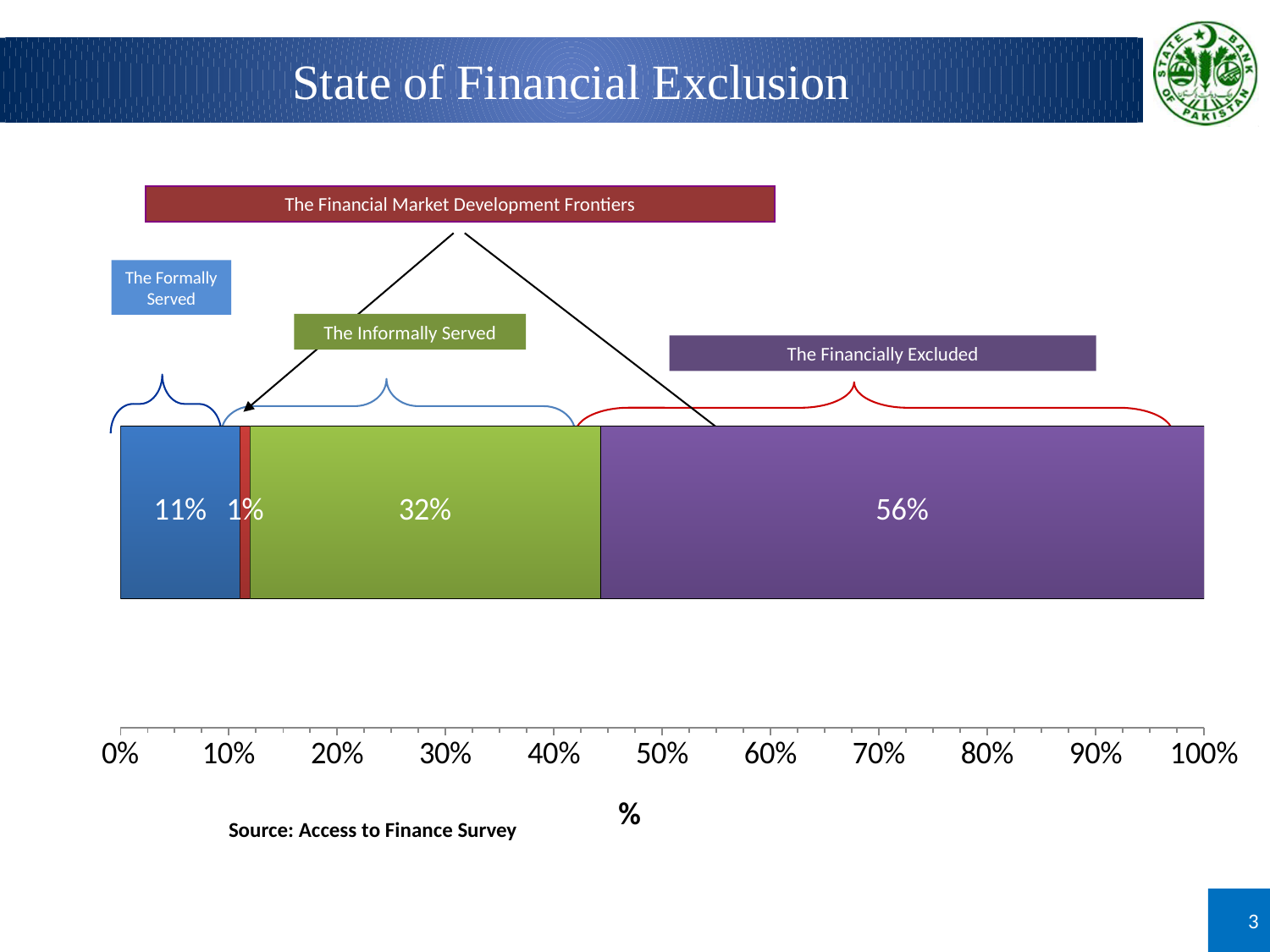
What source is cited for the chart? Access to Finance Survey What is the smallest value printed on the bar? 1% What percentage is shown for The Financially Excluded segment? 56% What is the difference between The Informally Served and The Formally Served segments? 21% Which is larger, The Formally Served segment or The Informally Served segment? The Informally Served What kind of chart is shown on the slide? stacked bar chart How many segments make up the stacked bar? 4 What percentage is shown for The Informally Served segment? 32% What is the difference between The Financially Excluded and The Informally Served segments? 24% Which segment of the bar is the largest? The Financially Excluded What is the total of all segments in the stacked bar? 100% What percentage is shown for The Formally Served segment? 11%